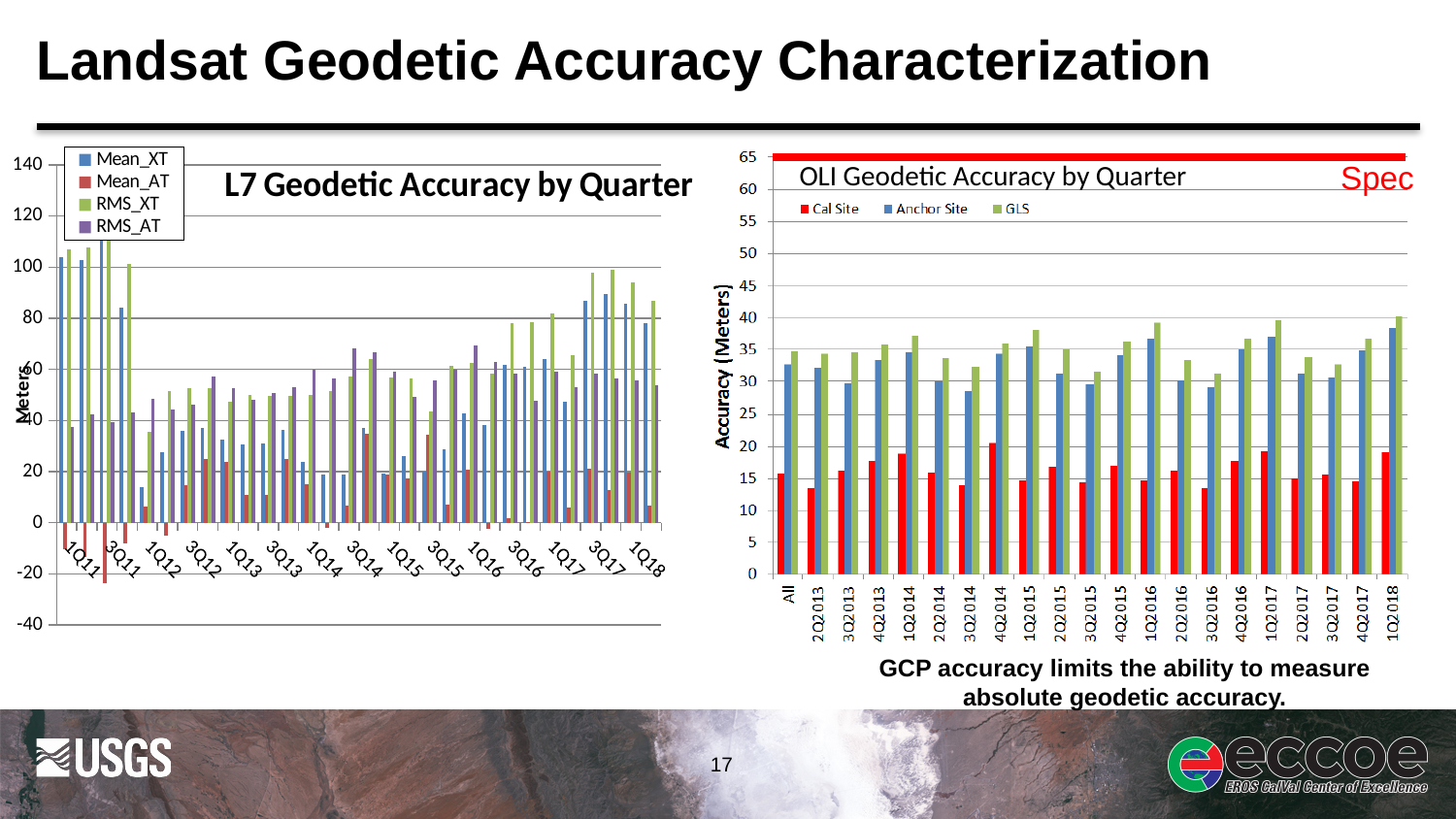
In the 'OLI Geodetic Accuracy by Quarter' chart, is the Anchor Site value for 3Q2014 greater or less than 30? less In the 'L7 Geodetic Accuracy by Quarter' chart, what are the four series named in the legend? Mean_XT, Mean_AT, RMS_XT, RMS_AT In the 'OLI Geodetic Accuracy by Quarter' chart, is the Anchor Site value for 1Q2018 greater or less than 35? greater How many series does the legend of the 'L7 Geodetic Accuracy by Quarter' chart list? 4 How many series does the legend of the 'OLI Geodetic Accuracy by Quarter' chart list? 3 What is the y-axis title of the 'OLI Geodetic Accuracy by Quarter' chart? Accuracy (Meters) In the 'OLI Geodetic Accuracy by Quarter' chart, which category has the highest Anchor Site value? 1Q2018 What kind of chart is the 'L7 Geodetic Accuracy by Quarter' chart on the left? bar chart In the 'OLI Geodetic Accuracy by Quarter' chart, for the 'All' category, which is larger: Cal Site or Anchor Site? Anchor Site In the 'OLI Geodetic Accuracy by Quarter' chart, is the Cal Site value for 'All' greater or less than 20? less How many categories are shown on the x axis of the 'OLI Geodetic Accuracy by Quarter' chart? 21